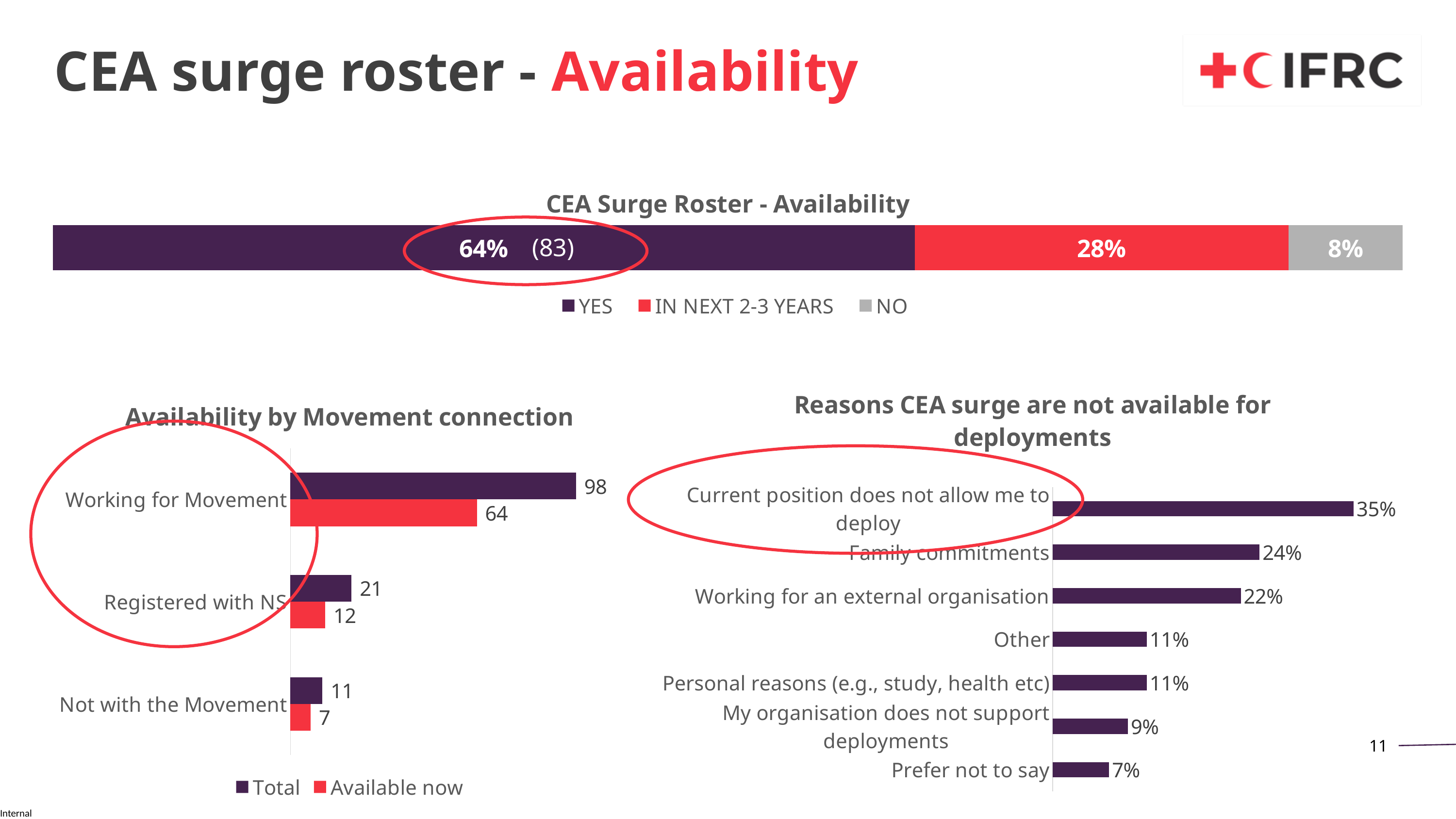
In the 'CEA Surge Roster - Availability' chart, what percentage is shown for IN NEXT 2-3 YEARS? 28% In the 'Reasons CEA surge are not available for deployments' chart, what percentage is shown for Family commitments? 24% In the 'Availability by Movement connection' chart, what is the difference between the Total and Available now values for Working for Movement? 34 In the 'Availability by Movement connection' chart, how many categories are shown? 3 In the 'CEA Surge Roster - Availability' chart, what percentage is shown for YES? 64% In the 'CEA Surge Roster - Availability' chart, how many series does the legend list? 3 In the 'Reasons CEA surge are not available for deployments' chart, which is larger: Working for an external organisation or My organisation does not support deployments? Working for an external organisation What kind of chart is 'Reasons CEA surge are not available for deployments'? Bar chart In the 'Availability by Movement connection' chart, what is the Total value for Working for Movement? 98 In the 'Availability by Movement connection' chart, which category has the lowest Total value? Not with the Movement In the 'Availability by Movement connection' chart, what is the Available now value for Registered with NS? 12 In the 'Reasons CEA surge are not available for deployments' chart, which reason has the highest percentage? Current position does not allow me to deploy